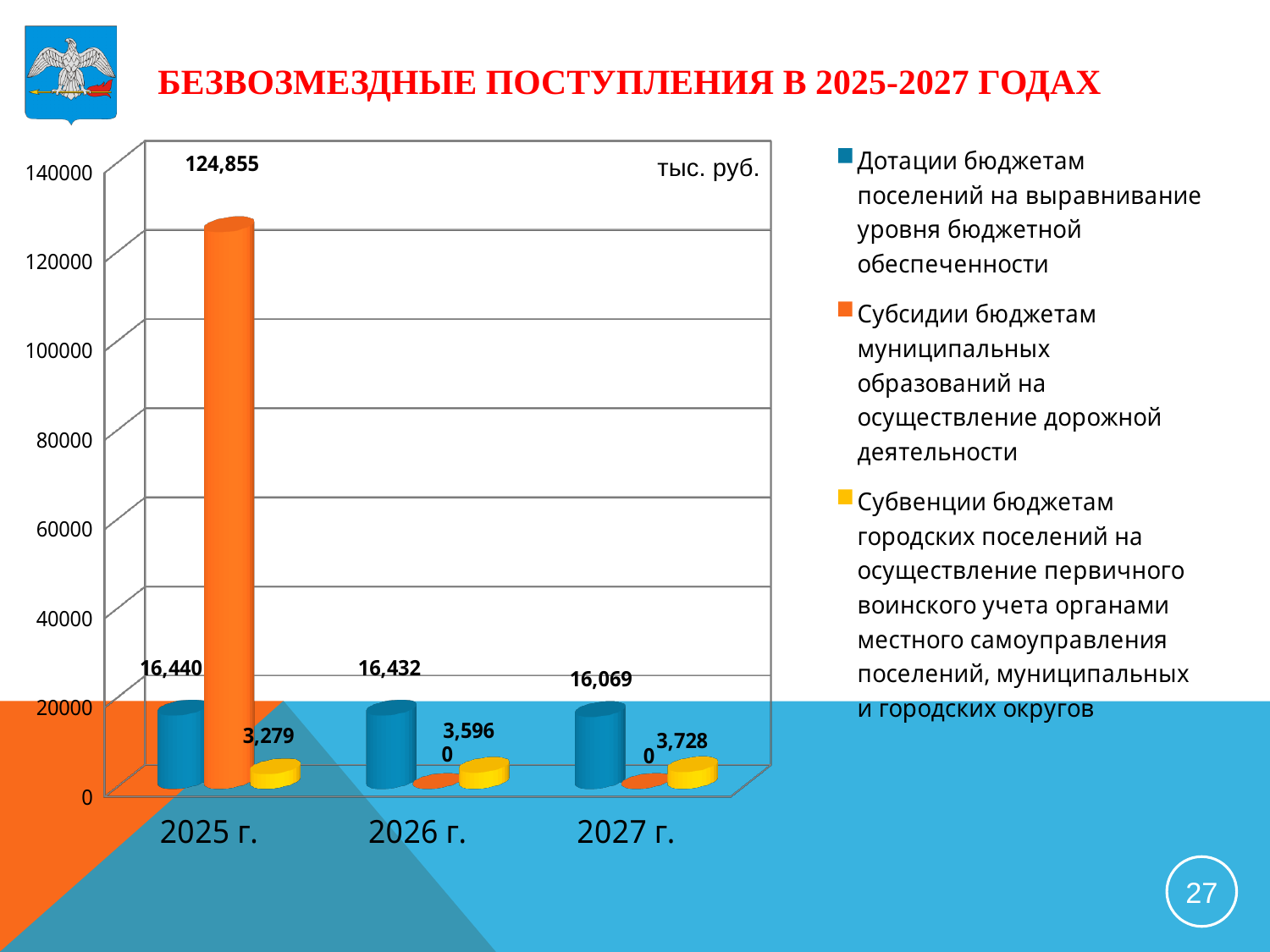
How many years are shown on the x axis of the chart? 3 What is the difference between the Субвенции values for 2027 г. and 2025 г.? 449 What kind of chart is shown on the slide? Bar chart What is the value of Субвенции бюджетам городских поселений for 2027 г.? 3,728 What is the value of Субсидии бюджетам муниципальных образований на осуществление дорожной деятельности for 2025 г.? 124,855 Is the value of Субсидии for 2025 г. greater or less than 120000? greater What is the value of Дотации бюджетам поселений на выравнивание уровня бюджетной обеспеченности for 2025 г.? 16,440 Which is larger for 2026 г.: Дотации бюджетам поселений or Субвенции бюджетам городских поселений? Дотации бюджетам поселений In which year is the value of Субвенции бюджетам городских поселений the lowest? 2025 г. What is the value of Субсидии бюджетам муниципальных образований на осуществление дорожной деятельности for 2026 г.? 0 In which year is the value of Дотации бюджетам поселений the lowest? 2027 г. How many series does the legend list? 3